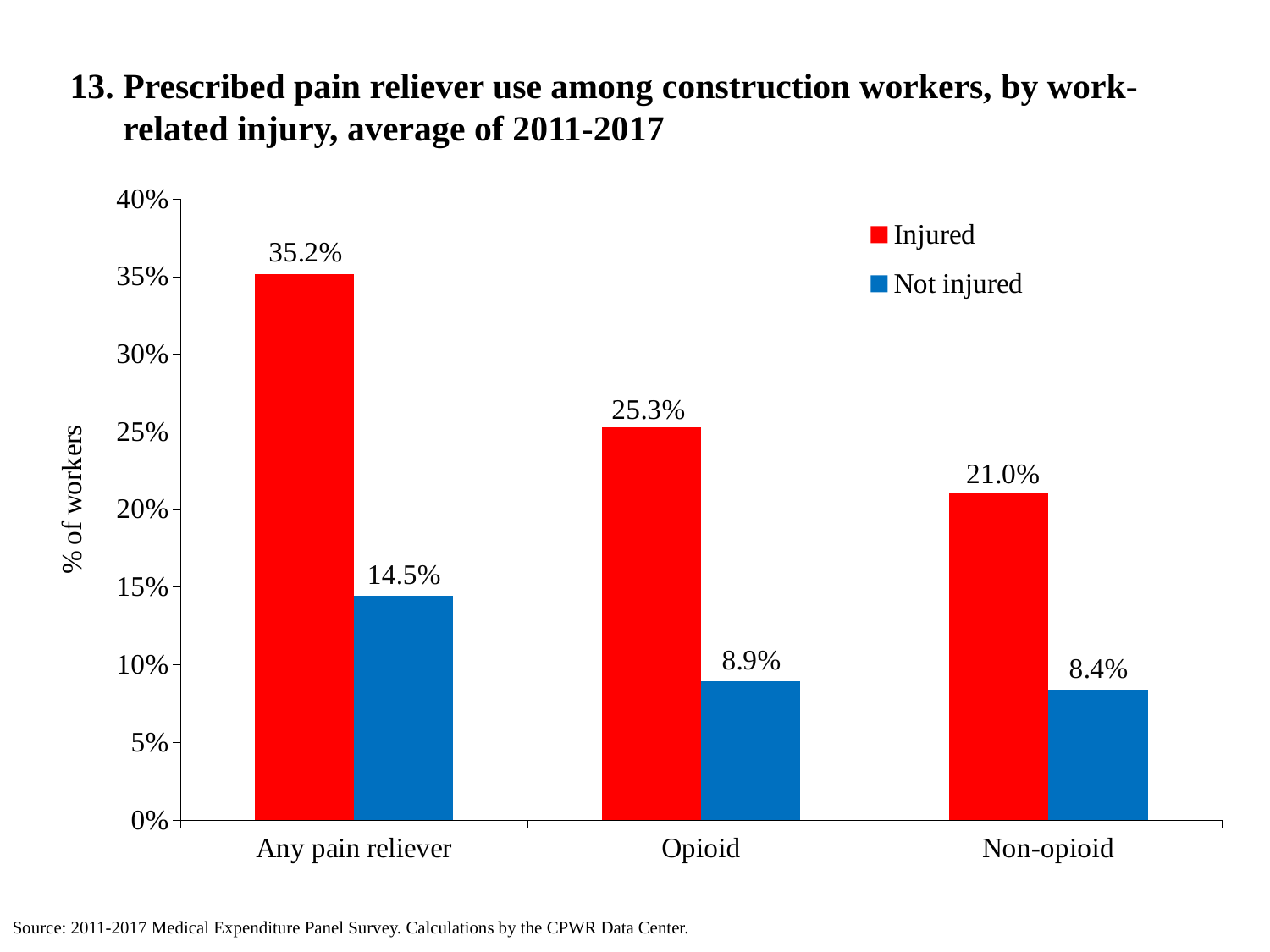
Which category has the highest value for the Injured series? Any pain reliever Which colour represents the Not injured series? Blue What is the difference between the Injured and Not injured values for Opioid? 16.4% How many series does the legend list? 2 Which category has the lowest value for the Not injured series? Non-opioid What is the value for Not injured workers in the Opioid category? 8.9% What kind of chart is shown on the slide? Bar chart Is the Injured value for Opioid greater or less than 25%? greater How many categories are shown on the x axis? 3 What is the value for Injured workers in the Non-opioid category? 21.0% Which is larger: the Not injured value for Any pain reliever or the Injured value for Non-opioid? Injured value for Non-opioid What percentage of injured construction workers used any pain reliever? 35.2%